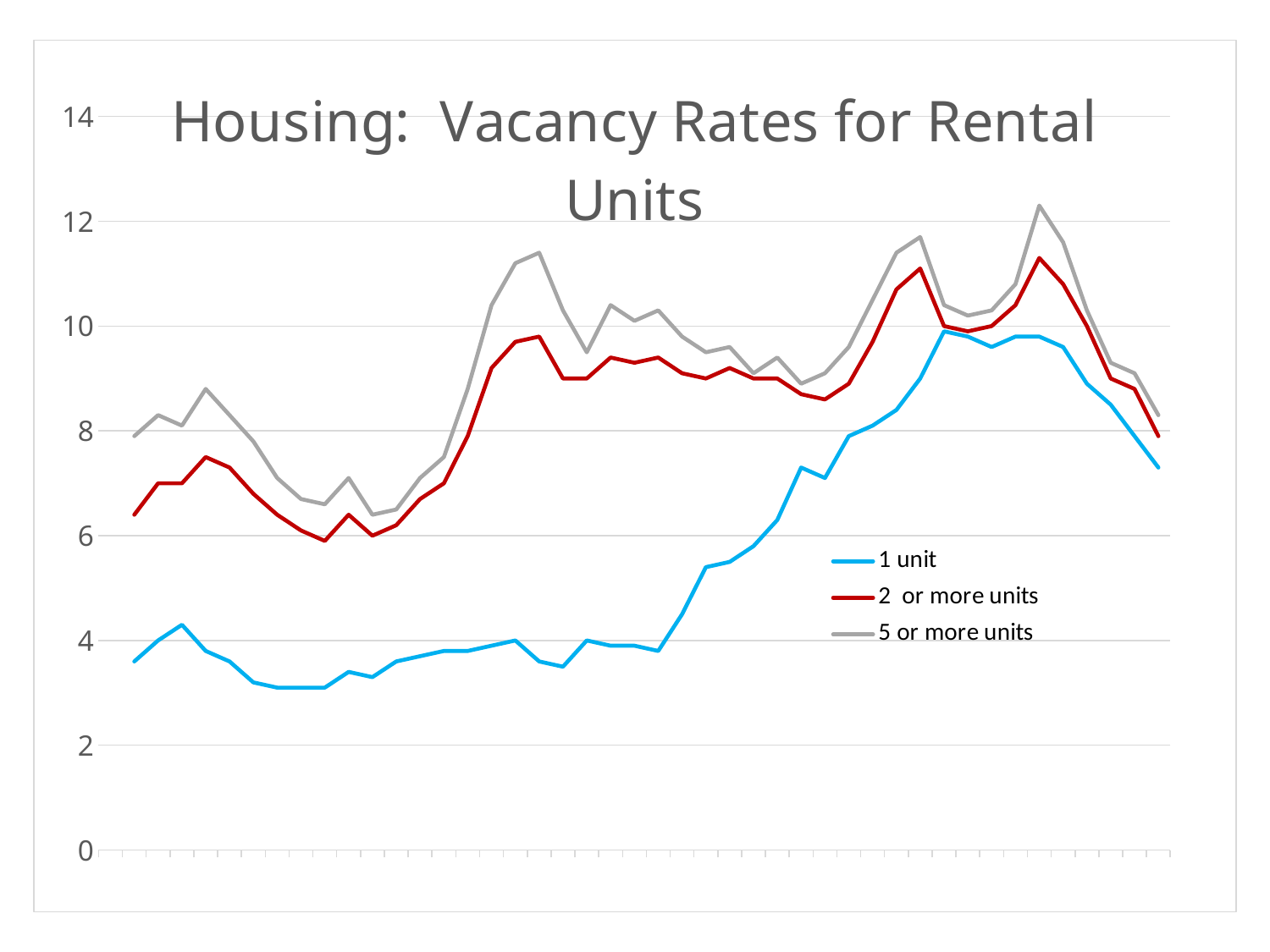
What is the title of the chart? Housing: Vacancy Rates for Rental Units Which series has the highest vacancy rates across the chart? 5 or more units Is the lowest value of the 2 or more units series greater or less than 7? less Is the highest value reached by the 1 unit series greater or less than 8? greater What are the three series named in the legend? 1 unit, 2 or more units, 5 or more units Is the lowest value of the 1 unit series greater or less than 4? less Overall, does the 1 unit series rise or fall from the left of the chart to the right? rise How many series does the legend list? 3 Which series is higher at the far right end of the chart, 1 unit or 2 or more units? 2 or more units What kind of chart is shown on the slide? line chart Which series has the lowest vacancy rates across the chart? 1 unit